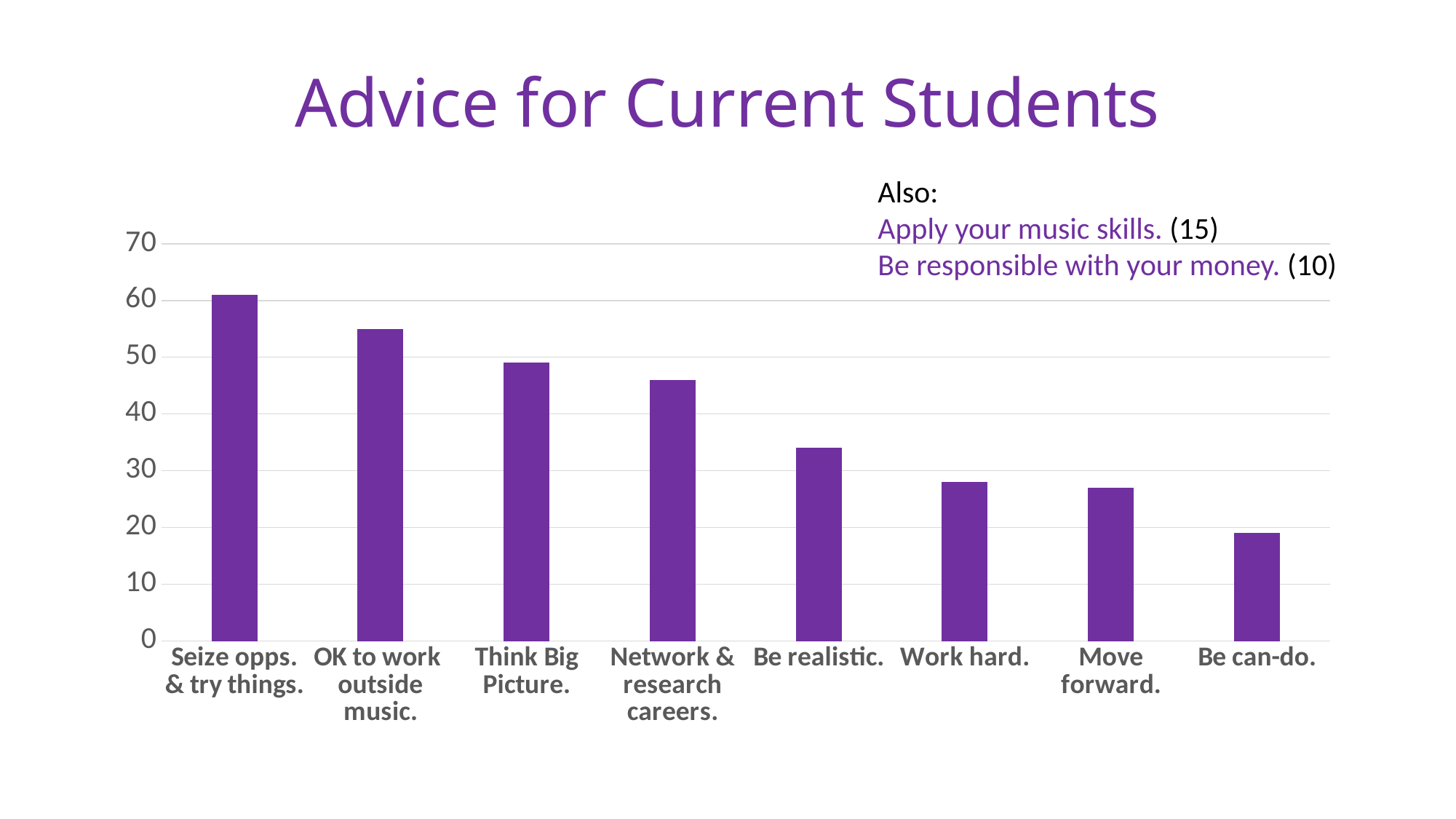
How many categories are plotted in the chart? 8 Which is larger, the value for "Think Big Picture." or the value for "Be realistic."? Think Big Picture. Is the value for "Work hard." greater or less than 30? less What kind of chart is shown on the slide? bar chart Which category has the highest value? Seize opps. & try things. What is the title of the chart on the slide? Advice for Current Students Is the value for "Be realistic." greater or less than 30? greater Is the value for "OK to work outside music." greater or less than 50? greater Which category has the lowest value? Be can-do. Do the values rise or fall moving from left to right along the x axis? fall